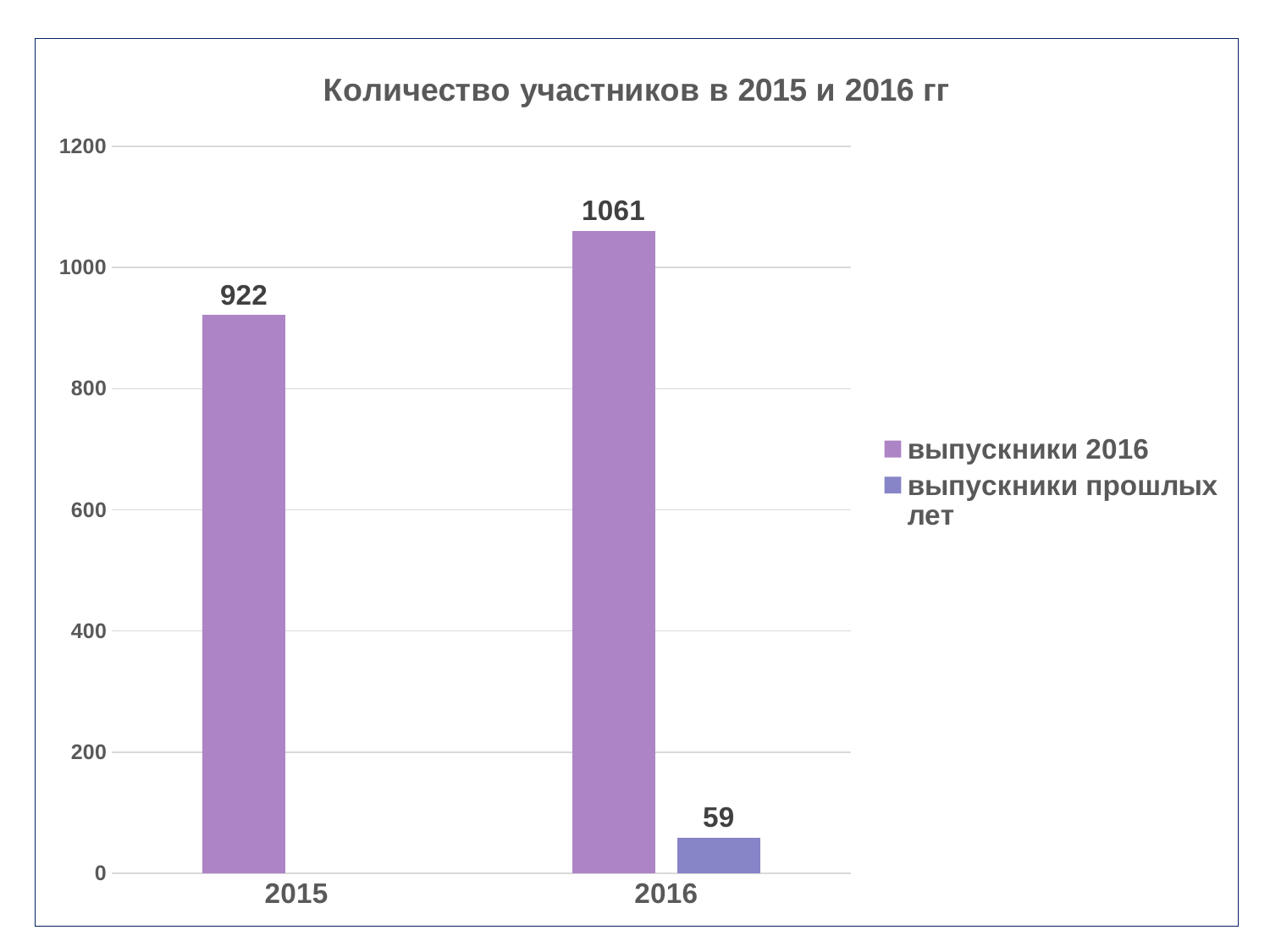
How many series does the legend list? 2 What is the value for выпускники прошлых лет in 2016? 59 What kind of chart is shown? bar chart Is the value for выпускники 2016 in 2015 greater or less than 1000? less What is the title of the chart? Количество участников в 2015 и 2016 гг What is the value for выпускники 2016 in 2016? 1061 What is the difference between the выпускники 2016 values for 2016 and 2015? 139 Which year has the higher value for выпускники 2016? 2016 How many years are shown on the x axis? 2 What is the value for выпускники 2016 in 2015? 922 Which is larger in 2016: выпускники 2016 or выпускники прошлых лет? выпускники 2016 Is the value for выпускники 2016 in 2016 greater or less than 1000? greater